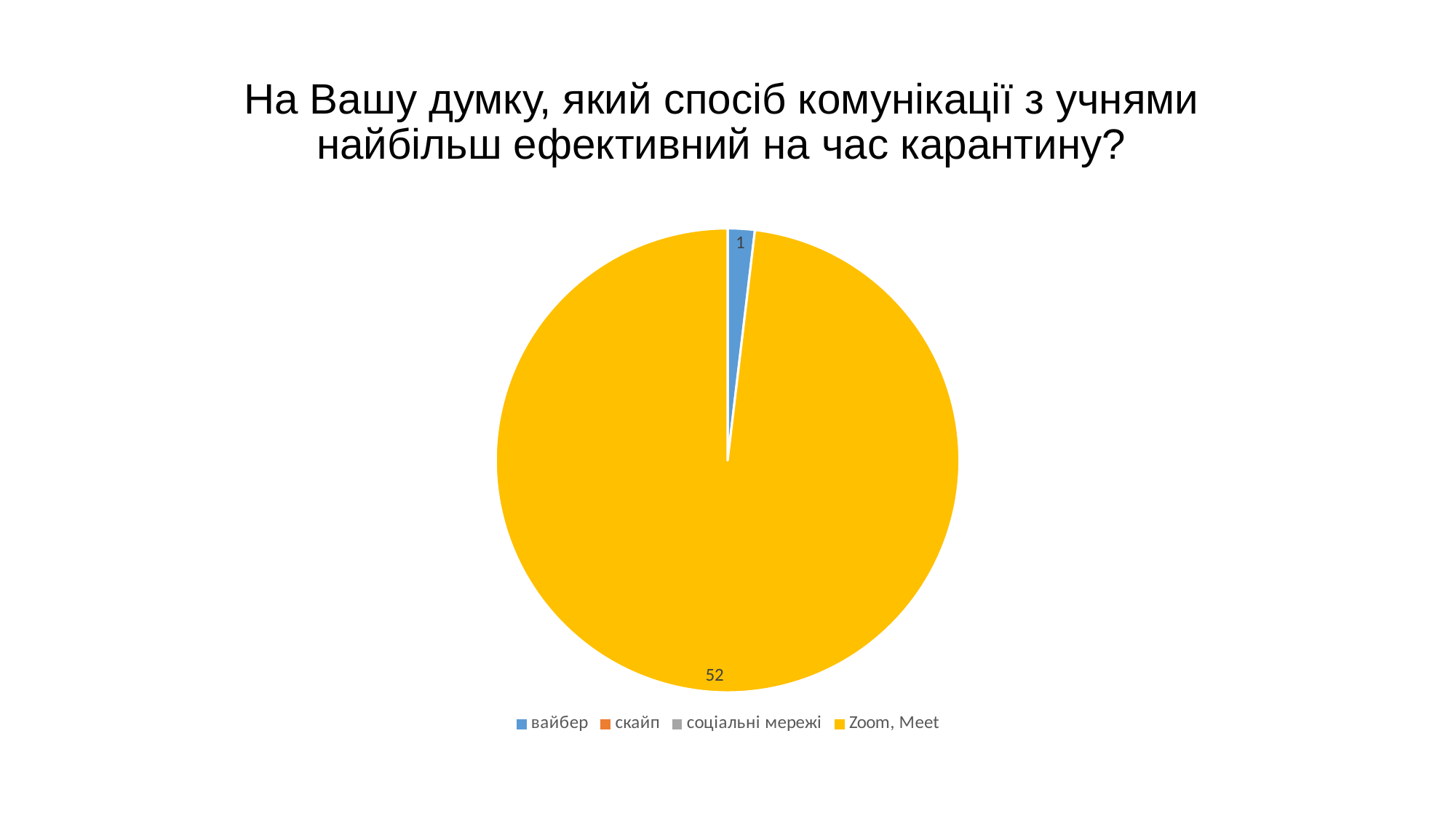
How many slices have a data label printed on the pie chart? 2 Which category has the largest slice in the pie chart? Zoom, Meet What kind of chart is shown on the slide? Pie chart What value is shown for the вайбер slice of the pie chart? 1 What value is shown for the Zoom, Meet slice of the pie chart? 52 What is the difference between the Zoom, Meet value and the вайбер value? 51 Which legend entry is shown in blue? вайбер How many entries does the legend of the chart list? 4 Which is larger, the value for вайбер or the value for Zoom, Meet? Zoom, Meet What colour is the Zoom, Meet slice in the pie chart? Yellow Which of the two labelled slices is smaller, вайбер or Zoom, Meet? вайбер